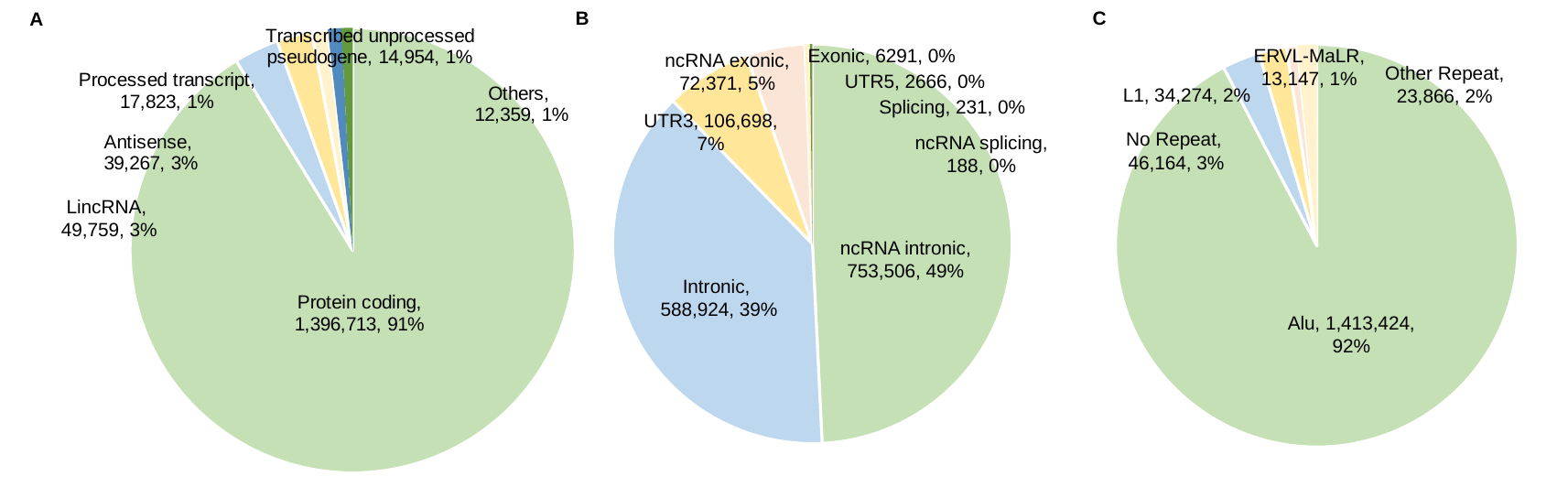
In chart B, which category has the largest share? ncRNA intronic In chart B, how many categories are shown in the pie? 8 In chart B, which is larger, ncRNA exonic or UTR3? UTR3 In chart A, what is the value for Protein coding? 1,396,713 In chart B, what is the difference between the Intronic and UTR3 values? 482,226 In chart C, what is the value for No Repeat? 46,164 In chart A, how many categories are shown in the pie? 6 In chart C, what share of the pie does Alu represent? 92% In chart A, what share of the pie does LincRNA represent? 3% In chart B, what is the value for ncRNA intronic? 753,506 In chart A, which category has the smallest value? Others What type of chart is chart C? Pie chart